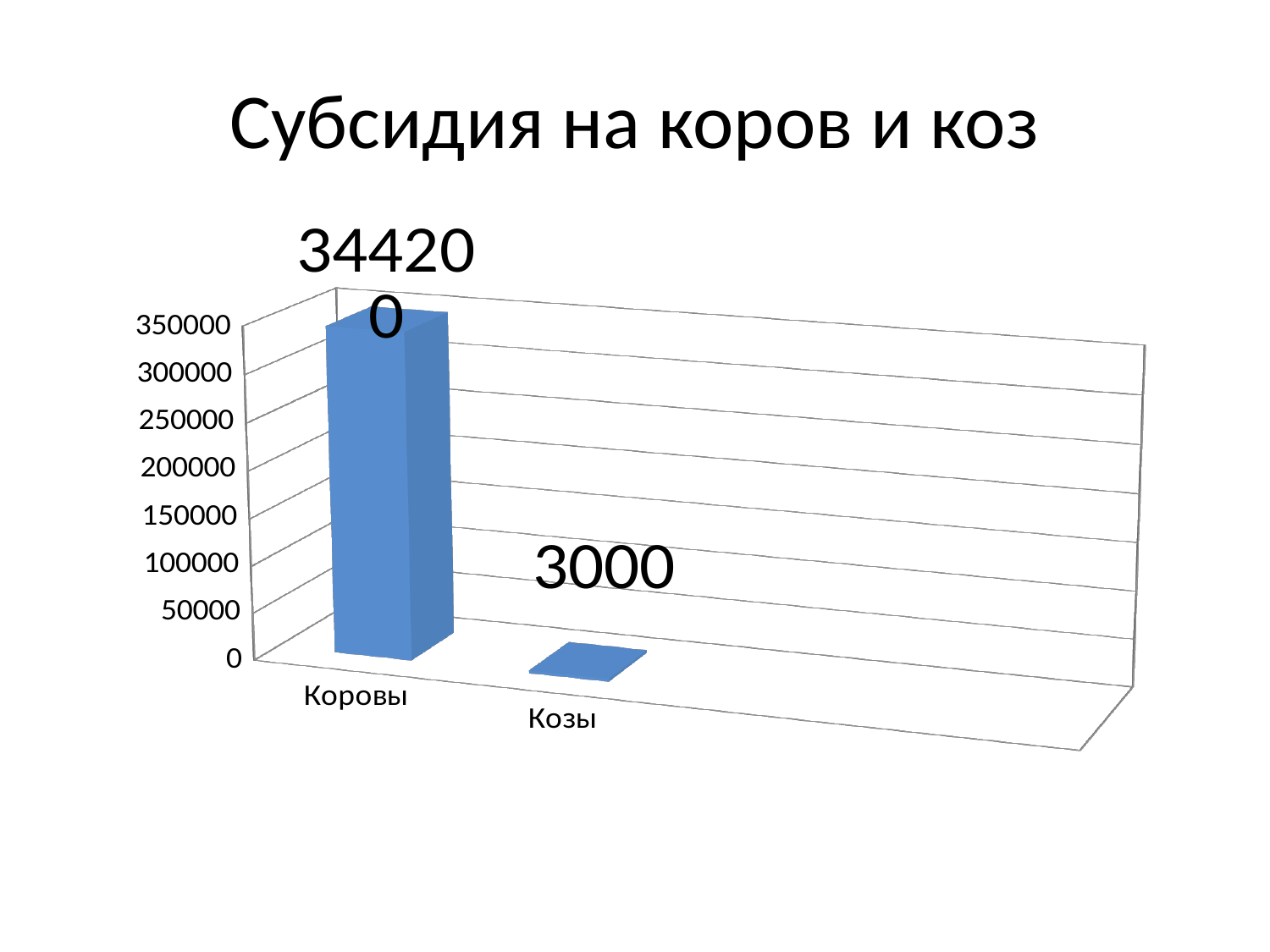
Which category has the lowest value? Козы Is the value for Козы greater or less than 50000? less How many categories are shown on the chart? 2 Which category has the highest value? Коровы Is the value for Коровы greater or less than 300000? greater What is the value for Козы? 3000 What is the value for Коровы? 344200 Which is larger, the value for Коровы or the value for Козы? Коровы What is the highest value shown on the vertical axis? 350000 What kind of chart is shown on the slide? bar chart What is the title of the slide? Субсидия на коров и коз What is the difference between the values for Коровы and Козы? 341200